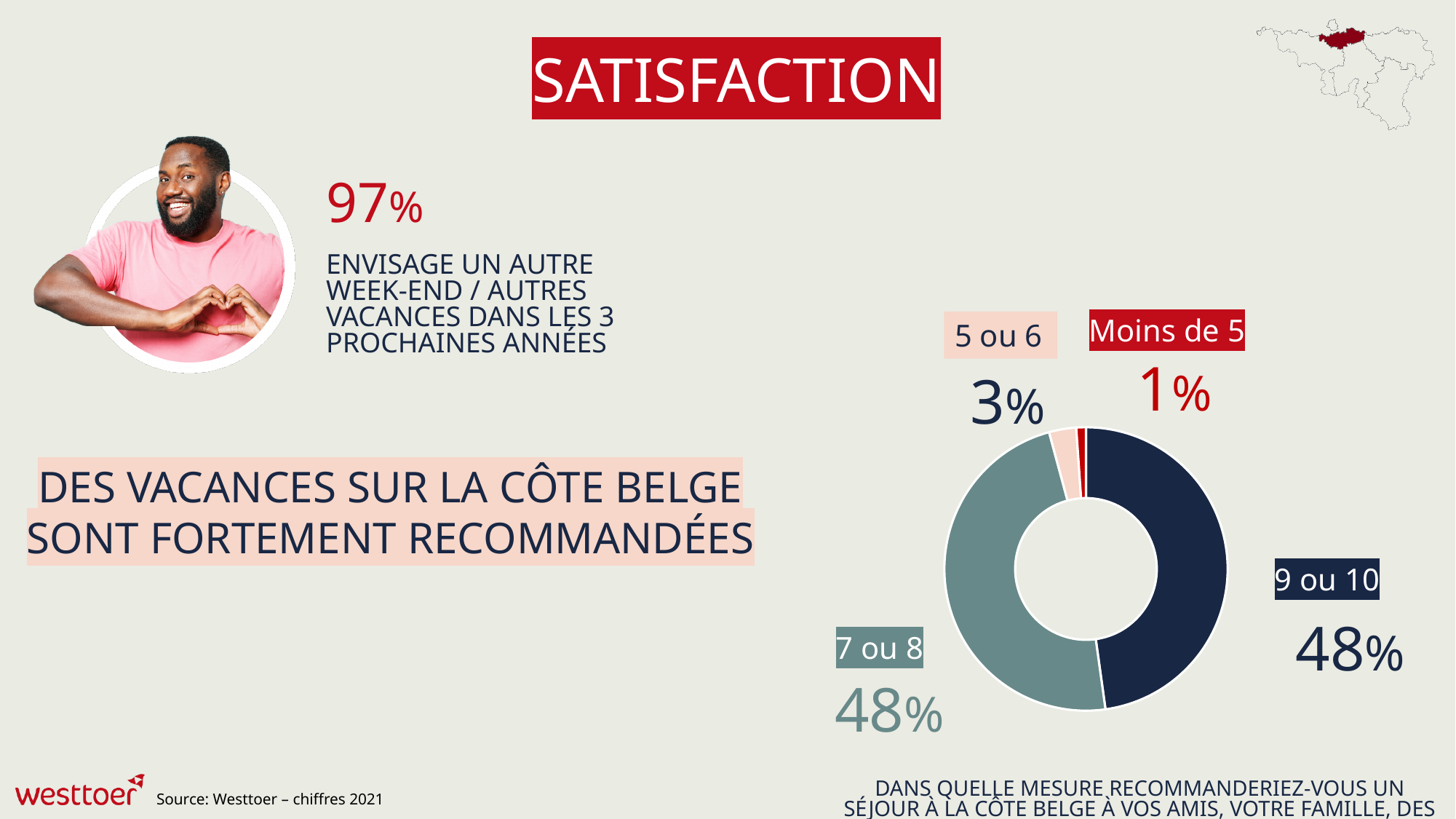
How many categories does the chart show? 4 What colour is the segment for Moins de 5? Red What percentage of respondents gave a score of Moins de 5? 1% What kind of chart is shown on the slide? Pie chart (donut) What is the combined share of respondents who gave a score of 7 or higher (7 ou 8 plus 9 ou 10)? 96% What is the difference between the share for 5 ou 6 and the share for Moins de 5? 2% What percentage of respondents gave a score of 5 ou 6? 3% Which is larger, the share for 5 ou 6 or the share for Moins de 5? 5 ou 6 What percentage of respondents gave a score of 7 ou 8? 48% What percentage of respondents gave a score of 9 ou 10? 48% Which category has the smallest share of the chart? Moins de 5 What colour is the segment for 9 ou 10? Dark navy blue